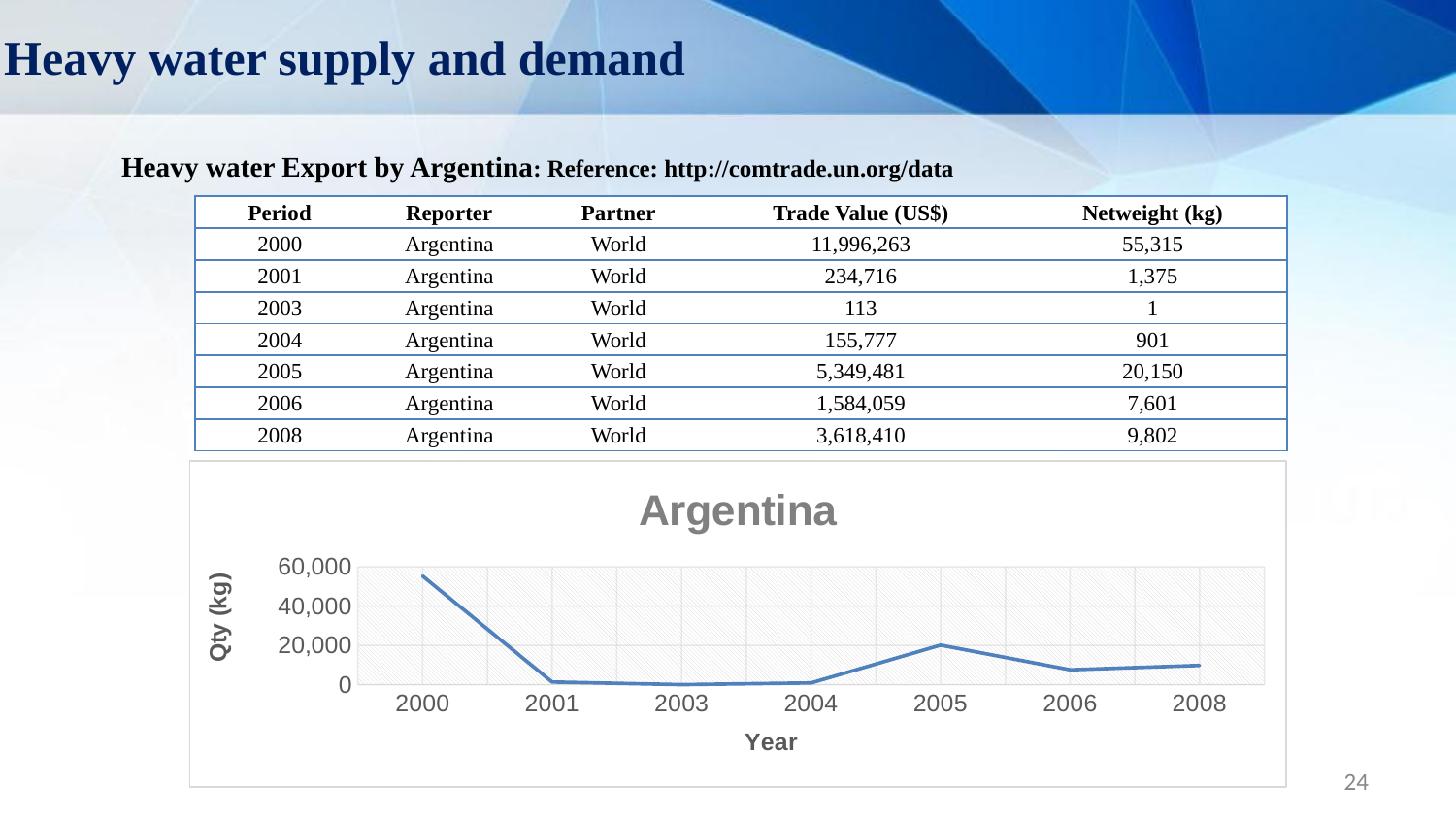
What is the title of the chart? Argentina Which year has the highest quantity in the chart? 2000 Does the quantity rise or fall from 2000 to 2001 in the chart? fall What kind of chart is shown on the slide? line chart Does the quantity rise or fall from 2004 to 2005 in the chart? rise In the chart, which year has the larger quantity, 2005 or 2006? 2005 How many years are plotted on the x axis of the chart? 7 Is the value for 2005 in the chart greater or less than 40,000? less Is the value for 2001 in the chart greater or less than 20,000? less Is the value for 2000 in the chart greater or less than 40,000? greater What is the label on the vertical axis of the chart? Qty (kg)